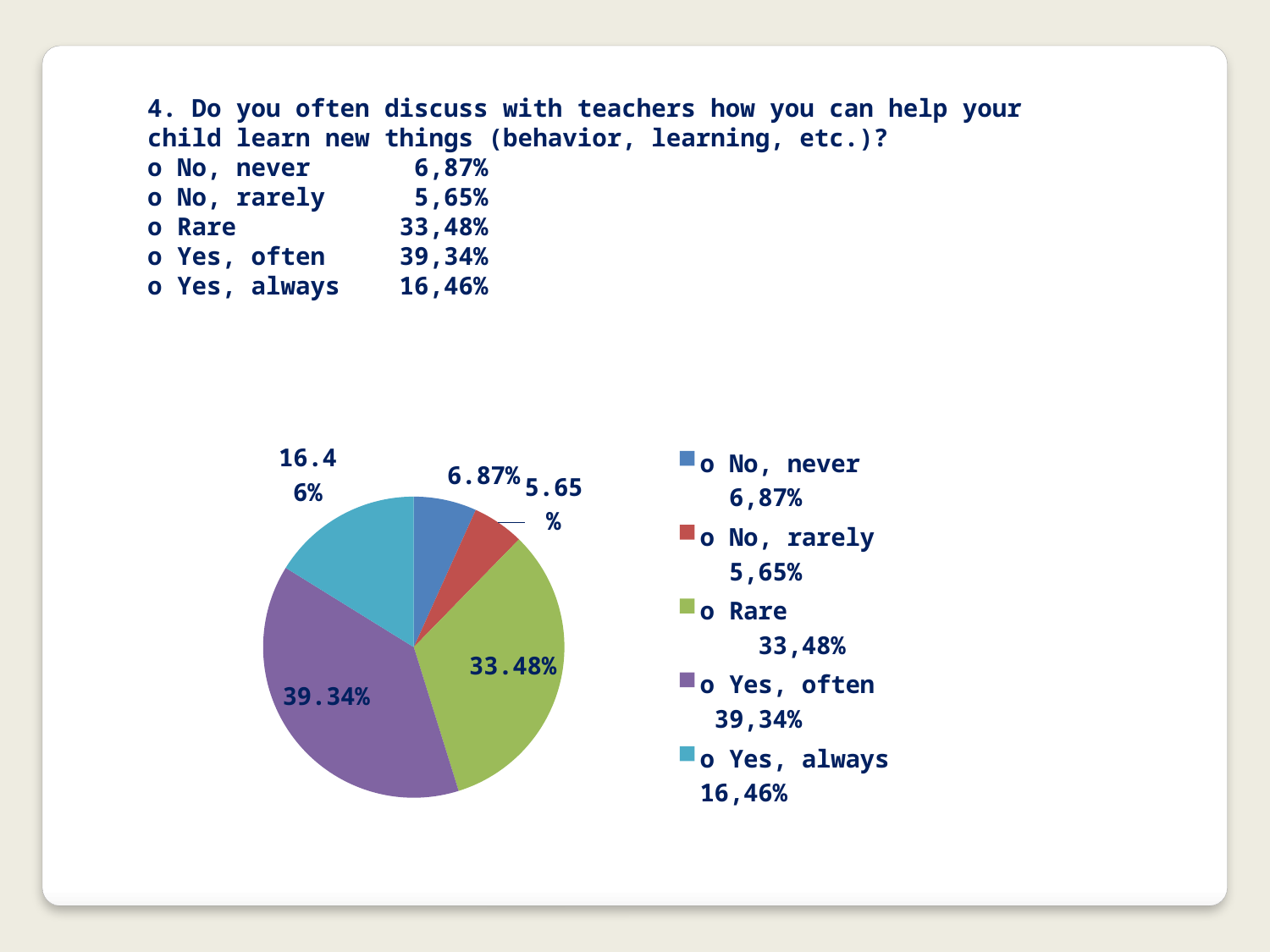
What is the value shown for the "Yes, often" slice? 39.34% What colour is the "Yes, often" slice in the pie chart? purple Which is larger, the "No, never" slice or the "No, rarely" slice? No, never What is the value shown for the "No, rarely" slice? 5.65% What is the difference between the "Yes, often" and "Rare" values? 5.86% Which category has the smallest slice of the pie? No, rarely Which category has the largest slice of the pie? Yes, often What is the value shown for the "Rare" slice? 33.48% What kind of chart is shown on the slide? pie chart What share of the pie does the "No, never" slice represent? 6.87% How many slices does the pie chart have? 5 What is the value shown for the "Yes, always" slice? 16.46%